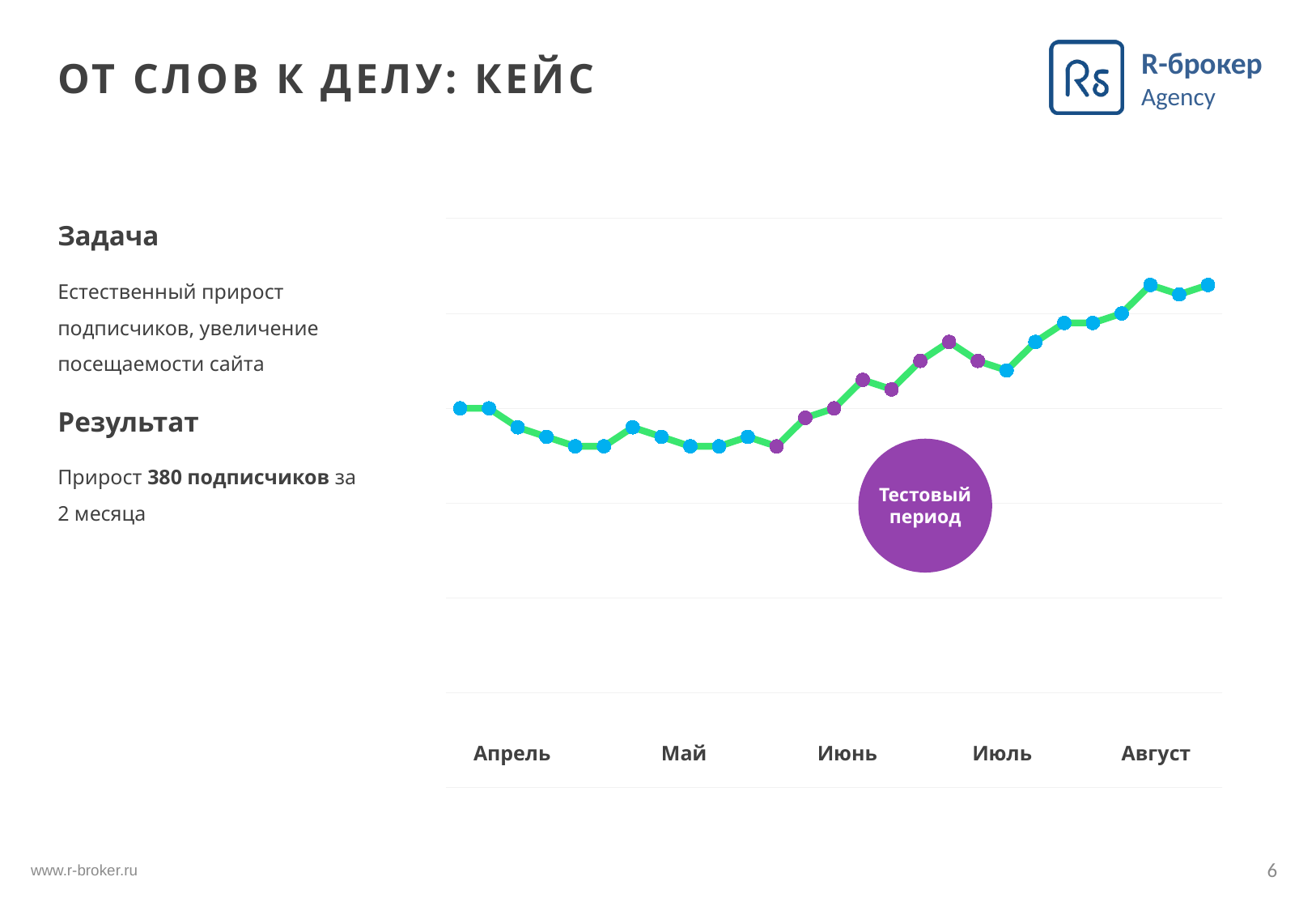
Are the values on the chart higher in Август or in Апрель? Август Which month is labelled first on the x axis of the chart? Апрель How many month labels are shown on the x axis of the chart? 5 Are the values on the chart higher in Июль or in Май? Июль Which month is labelled last on the x axis of the chart? Август Overall, do the values on the chart rise or fall from Апрель to Август? Rise Which month on the chart has the lowest values? Май Do the values on the chart rise or fall between Апрель and Май? Fall Do the values on the chart rise or fall between Июнь and Август? Rise What kind of chart is shown on the slide? Line chart Which month on the chart has the highest values? Август